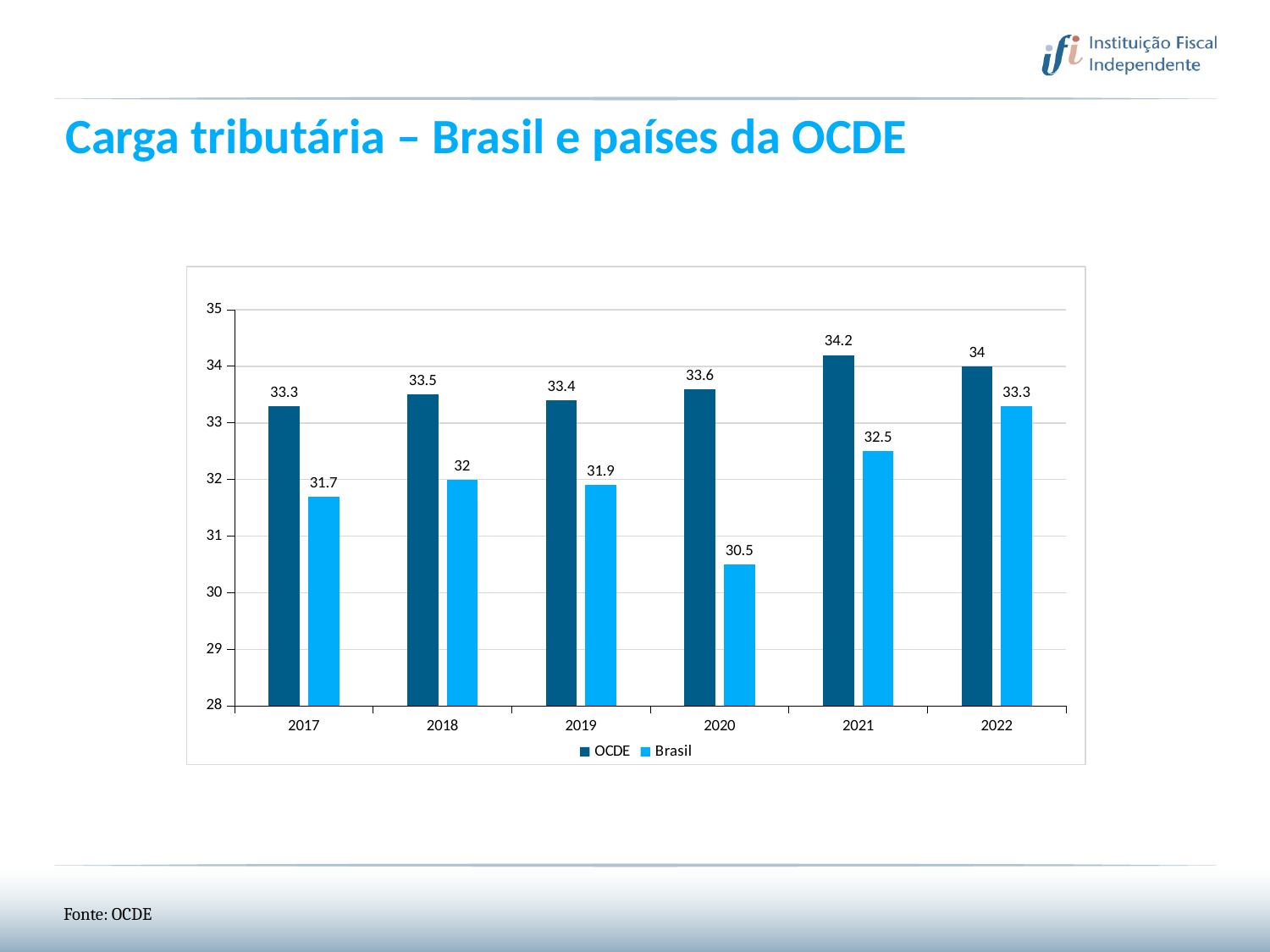
What is the difference between the OCDE and Brasil values in 2020? 3.1 What is the Brasil value for 2022? 33.3 Which is larger in 2017, the OCDE value or the Brasil value? OCDE Does the Brasil value rise or fall from 2020 to 2022? Rise What is the OCDE value for 2021? 34.2 What is the title of the slide? Carga tributária – Brasil e países da OCDE What kind of chart is shown on the slide? Bar chart How many years are shown on the x axis? 6 In which year is the Brasil value lowest? 2020 What is the Brasil value for 2020? 30.5 How many series does the legend list? 2 In which year is the OCDE value highest? 2021